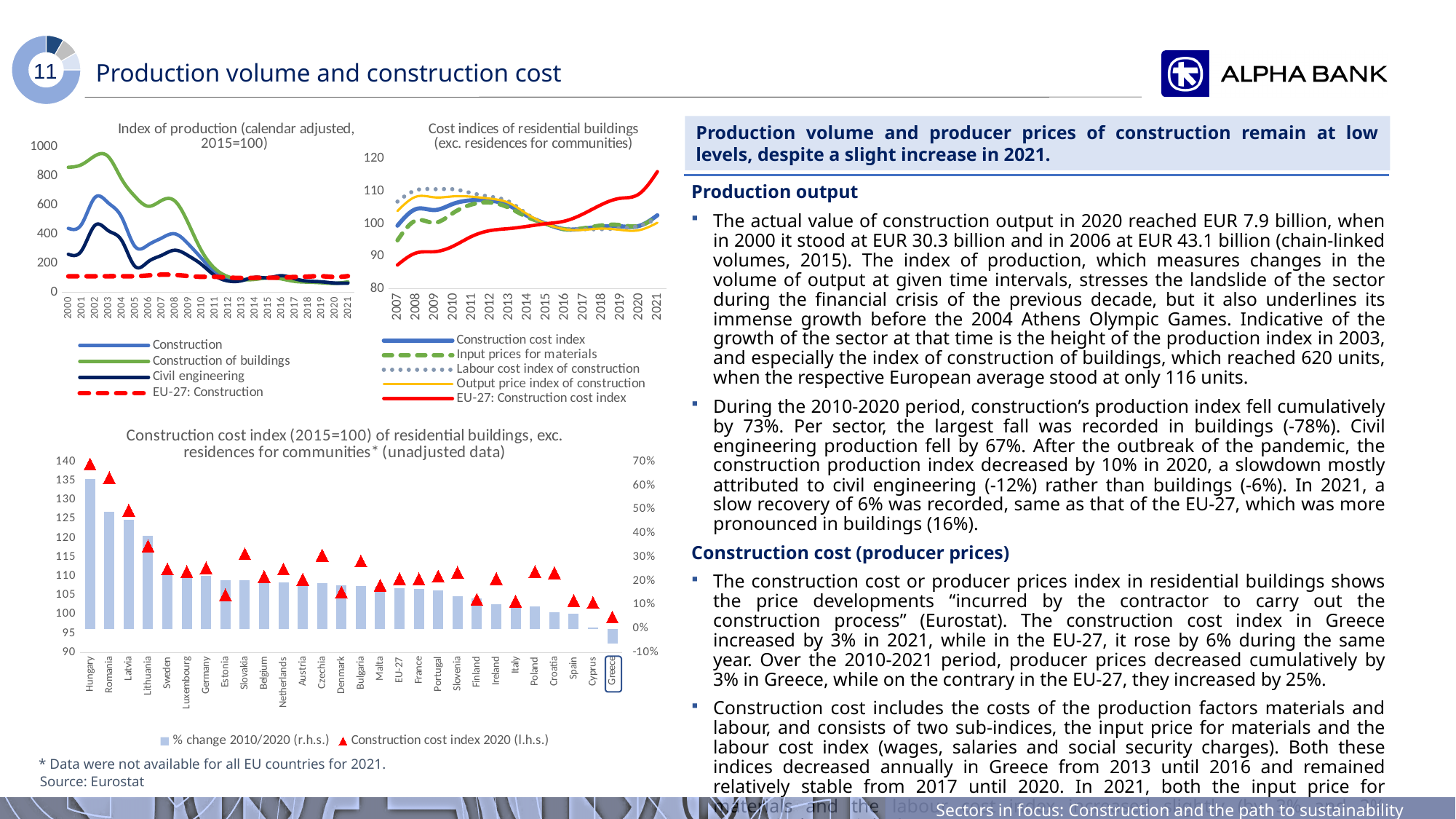
In the 'Index of production (calendar adjusted, 2015=100)' chart, does the Construction of buildings series rise or fall from 2003 to 2021? fall In the 'Cost indices of residential buildings (exc. residences for communities)' chart, does the EU-27: Construction cost index rise or fall from 2007 to 2021? rise How many series does the legend of the 'Index of production (calendar adjusted, 2015=100)' chart list? 4 In the 'Cost indices of residential buildings (exc. residences for communities)' chart, is the value for EU-27: Construction cost index in 2021 greater or less than 110? greater In the 'Cost indices of residential buildings (exc. residences for communities)' chart, which series is lowest in 2007? EU-27: Construction cost index In the 'Index of production (calendar adjusted, 2015=100)' chart, which series is highest in 2003? Construction of buildings How many series does the legend of the 'Cost indices of residential buildings (exc. residences for communities)' chart list? 5 In the 'Construction cost index (2015=100) of residential buildings' bar chart at the bottom left, which country has the highest bar for % change 2010/2020? Hungary In the 'Index of production (calendar adjusted, 2015=100)' chart, is the value for Construction of buildings in 2003 greater or less than 800? greater How many countries are shown on the x axis of the 'Construction cost index (2015=100) of residential buildings' bar chart at the bottom left? 28 What type of chart is the 'Index of production (calendar adjusted, 2015=100)' chart? line chart In the 'Construction cost index (2015=100) of residential buildings' bar chart at the bottom left, is the % change 2010/2020 bar for Greece greater or less than 0%? less